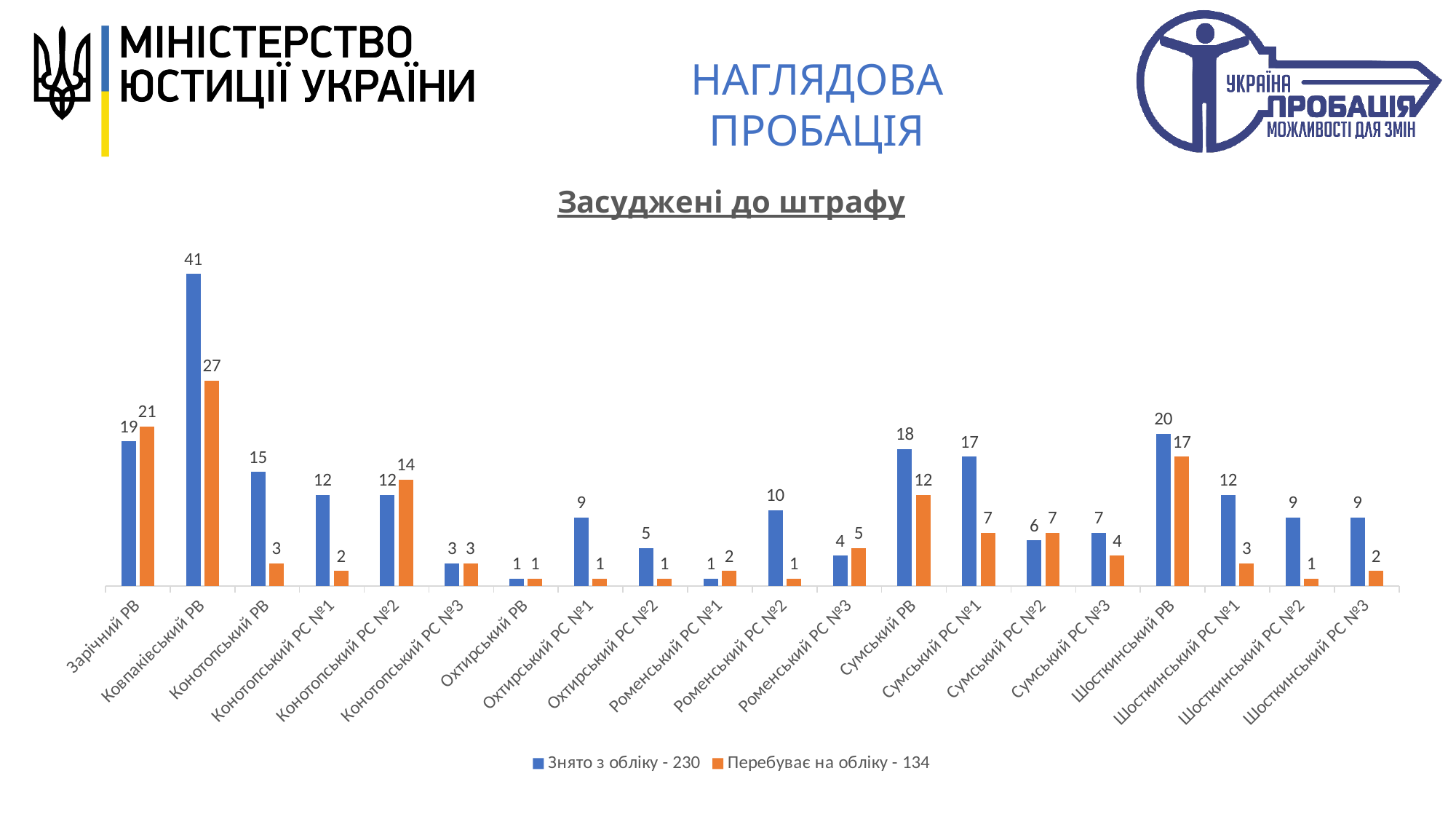
How many categories are shown on the x axis? 20 For Конотопський РС №2, which is larger: 'Знято з обліку' or 'Перебуває на обліку'? Перебуває на обліку What is the value of 'Перебуває на обліку' for Роменський РС №3? 5 What is the difference between 'Знято з обліку' and 'Перебуває на обліку' for Сумський РС №1? 10 What is the value of 'Знято з обліку' for Шосткинський РВ? 20 What is the value of 'Перебуває на обліку' for Зарічний РВ? 21 Which category has the highest 'Знято з обліку' value? Ковпаківський РВ What is the value of 'Знято з обліку' for Ковпаківський РВ? 41 How many series does the legend list? 2 What type of chart is shown on the slide? bar chart What is the title of the chart? Засуджені до штрафу Which category has the highest 'Перебуває на обліку' value? Ковпаківський РВ